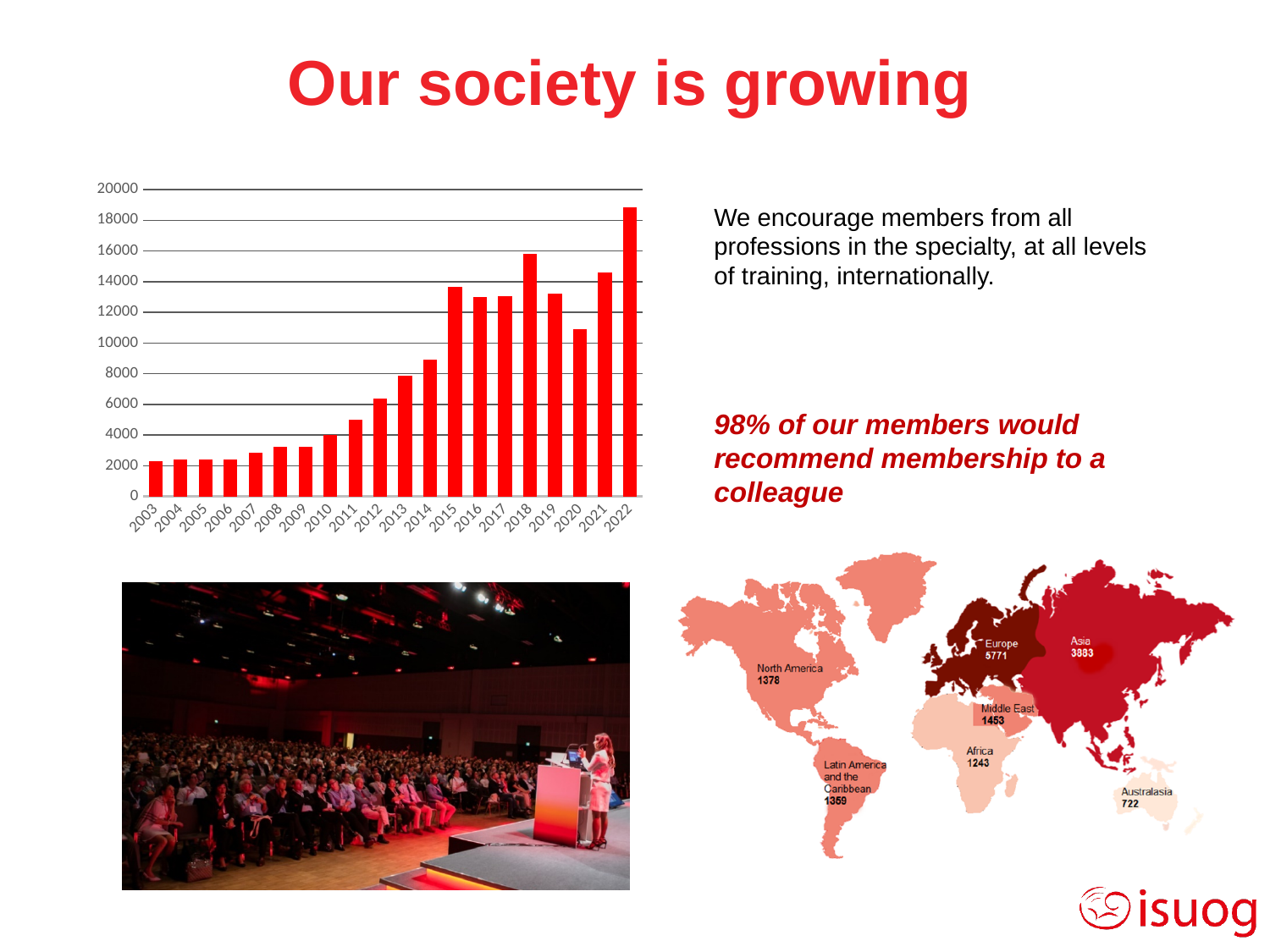
In the bar chart, is the value for 2018 greater or less than 14000? greater In the bar chart, which year has the lowest bar? 2003 What kind of chart is shown on the left of the slide? bar chart In the bar chart, how many years are shown on the x axis? 20 In the bar chart, is the value for 2022 greater or less than 18000? greater In the bar chart, which year has the highest bar? 2022 What colour are the bars in the bar chart? red In the bar chart, is the value for 2020 greater or less than 12000? less On the world map, which region has the smallest number? Australasia In the bar chart, which year has the larger value, 2018 or 2020? 2018 On the world map, what is the number shown for Europe? 5771 In the bar chart, do the values generally rise or fall from 2003 to 2022? rise